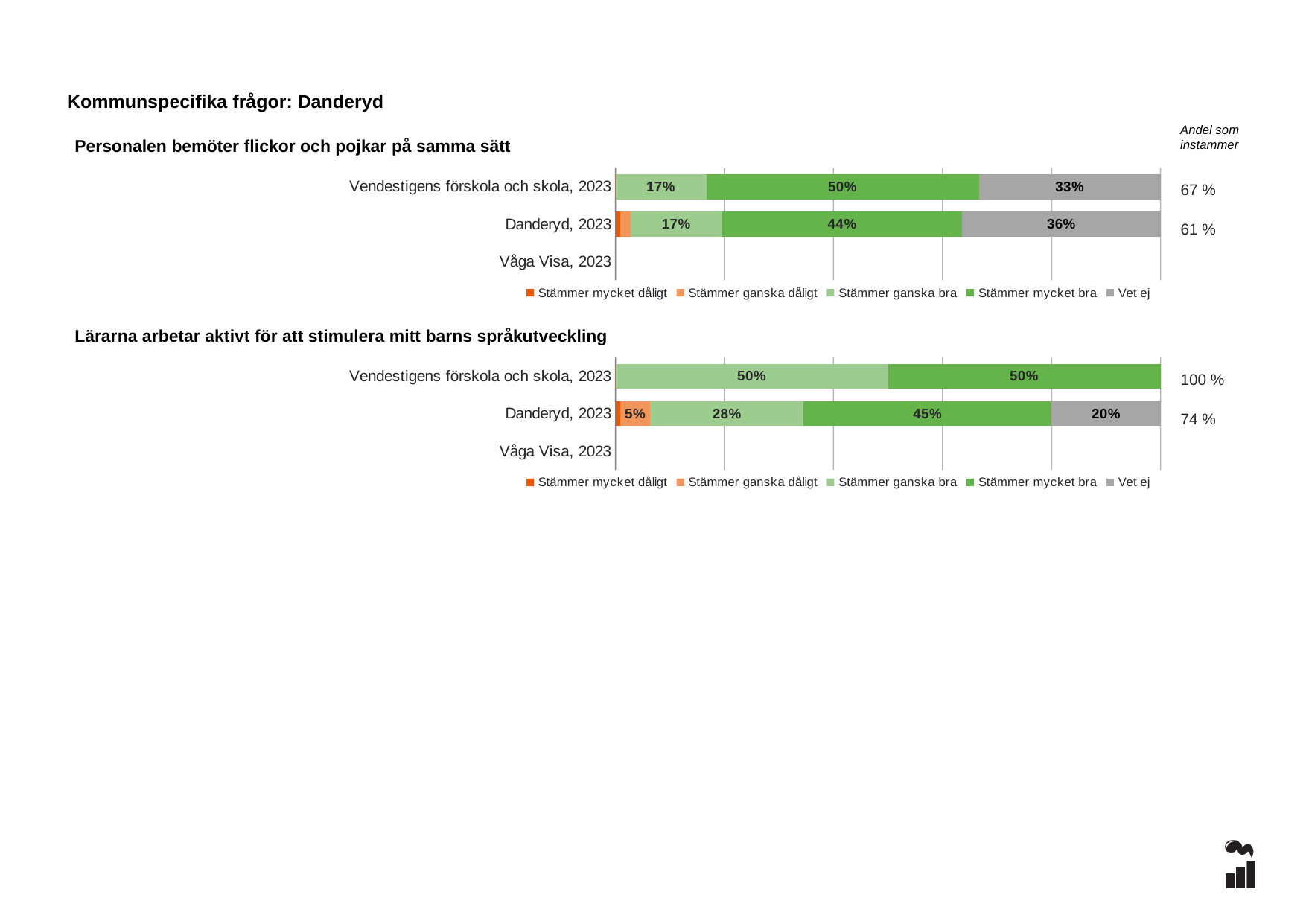
In the chart 'Lärarna arbetar aktivt för att stimulera mitt barns språkutveckling', which segment is the largest in the Danderyd, 2023 bar? Stämmer mycket bra In the chart 'Personalen bemöter flickor och pojkar på samma sätt', what is the 'Stämmer mycket bra' value for Vendestigens förskola och skola, 2023? 50% In the chart 'Personalen bemöter flickor och pojkar på samma sätt', what is the 'Andel som instämmer' shown for Vendestigens förskola och skola, 2023? 67 % In the chart 'Lärarna arbetar aktivt för att stimulera mitt barns språkutveckling', what is the 'Stämmer ganska bra' value for Danderyd, 2023? 28% In the chart 'Personalen bemöter flickor och pojkar på samma sätt', what is the 'Vet ej' value for Danderyd, 2023? 36% How many category rows are shown in the chart 'Lärarna arbetar aktivt för att stimulera mitt barns språkutveckling'? 3 In the chart 'Personalen bemöter flickor och pojkar på samma sätt', what is the difference between the 'Stämmer mycket bra' values for Vendestigens förskola och skola, 2023 and Danderyd, 2023? 6 percentage points In the chart 'Lärarna arbetar aktivt för att stimulera mitt barns språkutveckling', what is the 'Stämmer ganska dåligt' value for Danderyd, 2023? 5% How many series does the legend of the chart 'Personalen bemöter flickor och pojkar på samma sätt' list? 5 In the chart 'Lärarna arbetar aktivt för att stimulera mitt barns språkutveckling', which row has the higher 'Stämmer mycket bra' value, Vendestigens förskola och skola, 2023 or Danderyd, 2023? Vendestigens förskola och skola, 2023 What kind of chart is 'Personalen bemöter flickor och pojkar på samma sätt'? Stacked bar chart In the chart 'Lärarna arbetar aktivt för att stimulera mitt barns språkutveckling', what is the 'Andel som instämmer' shown for Danderyd, 2023? 74 %